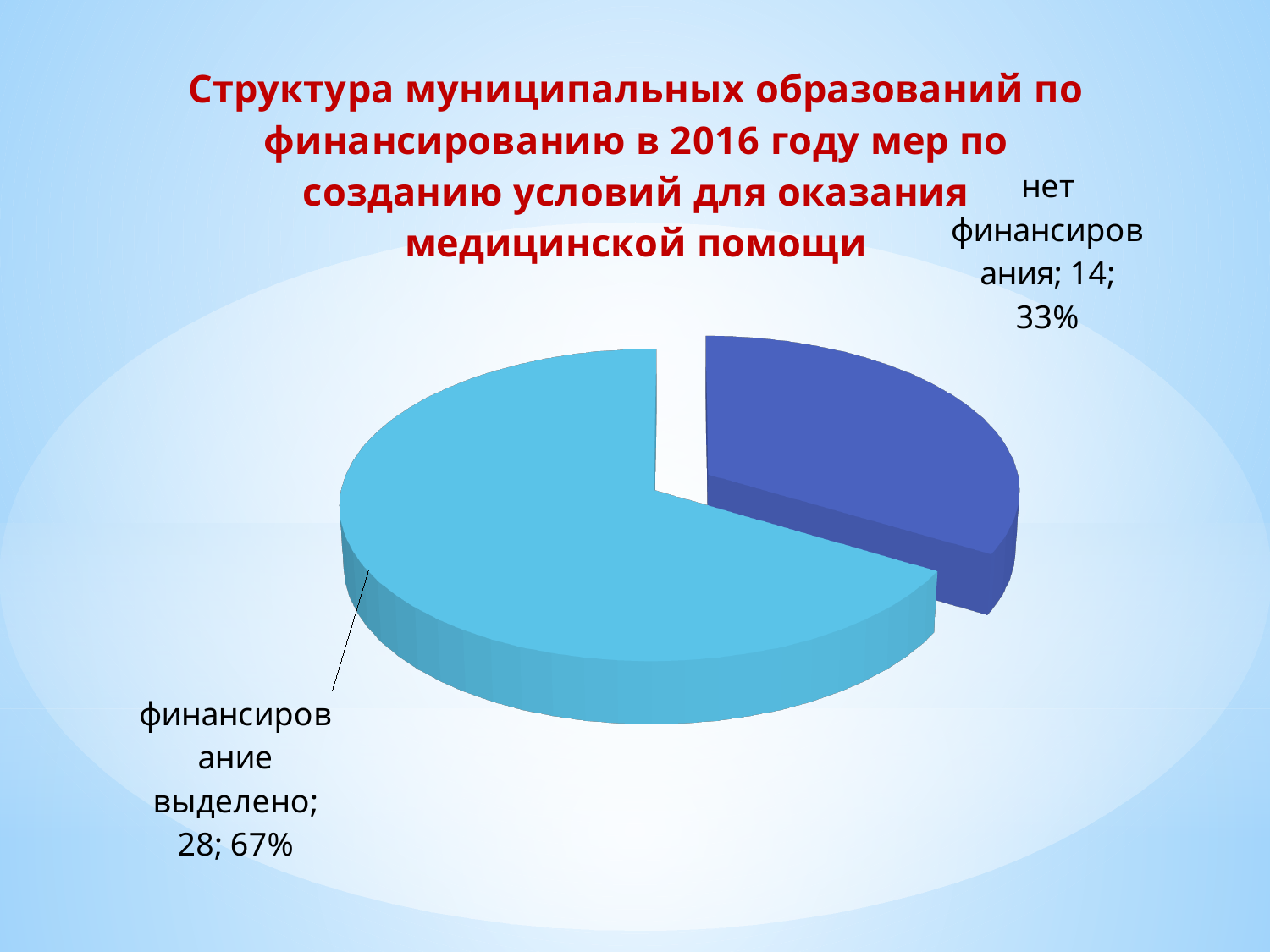
What share of the pie does "финансирование выделено" represent? 67% What is the total of the two slice values? 42 What kind of chart is shown on the slide? pie chart What share of the pie does "нет финансирования" represent? 33% What is the value for "нет финансирования"? 14 How many slices does the pie chart have? 2 Which category has the smallest slice? нет финансирования What colour is the slice for "нет финансирования"? dark blue What is the difference between the values for "финансирование выделено" and "нет финансирования"? 14 Which is larger: "финансирование выделено" or "нет финансирования"? финансирование выделено Which category has the largest slice? финансирование выделено What is the value for "финансирование выделено"? 28